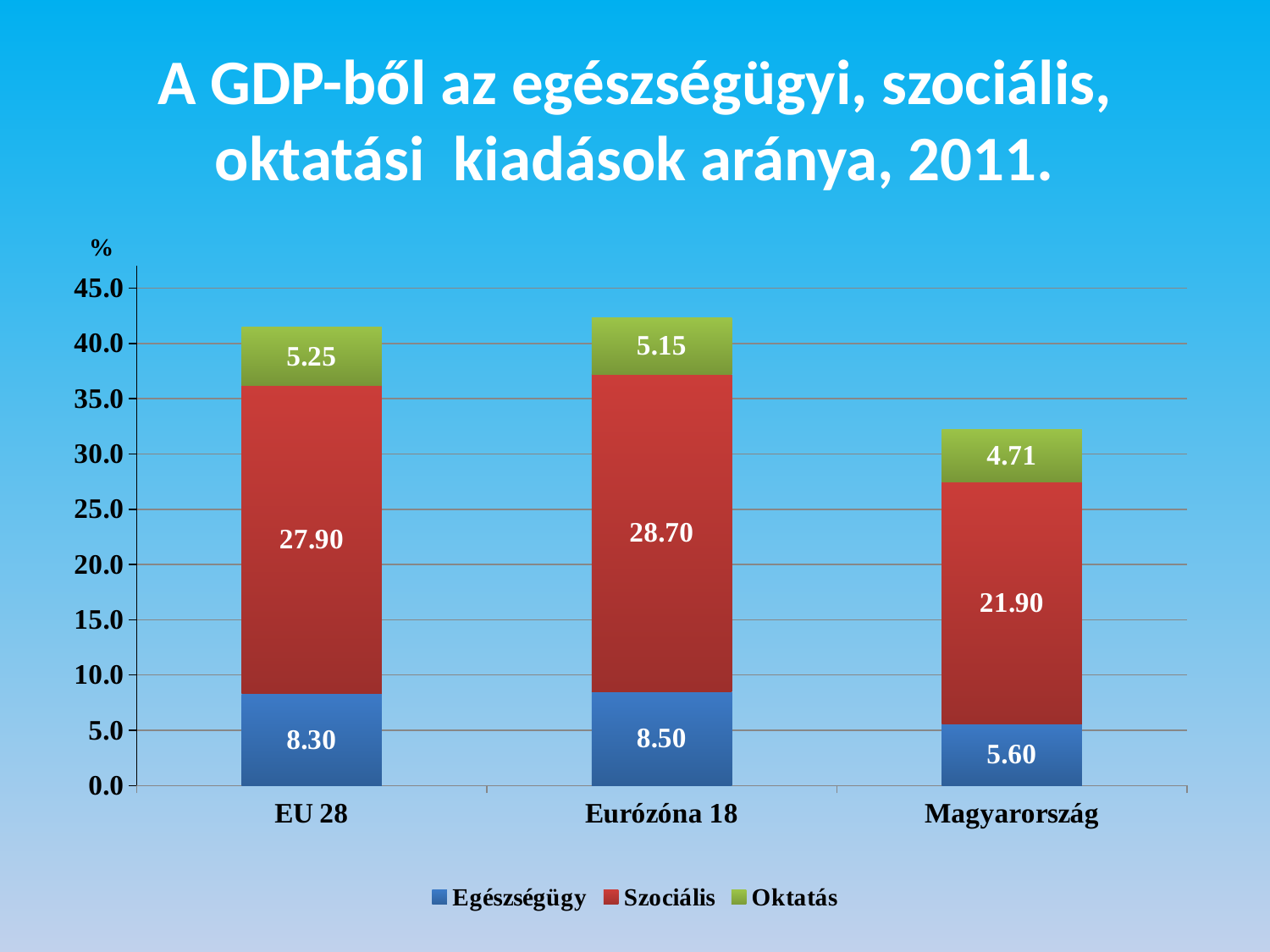
Which category has the lowest Egészségügy value? Magyarország How many series does the legend list? 3 What is the total of the stacked bar for Magyarország? 32.21 Which is larger, the Oktatás value for EU 28 or for Eurózóna 18? EU 28 What kind of chart is shown on the slide? Stacked bar chart What is the Oktatás value for EU 28? 5.25 How many categories are shown on the x axis? 3 Which category has the highest Szociális value? Eurózóna 18 What is the Egészségügy value for Eurózóna 18? 8.50 What is the Szociális value for Magyarország? 21.90 What is the total of the stacked bar for Eurózóna 18? 42.35 What is the difference between the Szociális values for EU 28 and Magyarország? 6.00